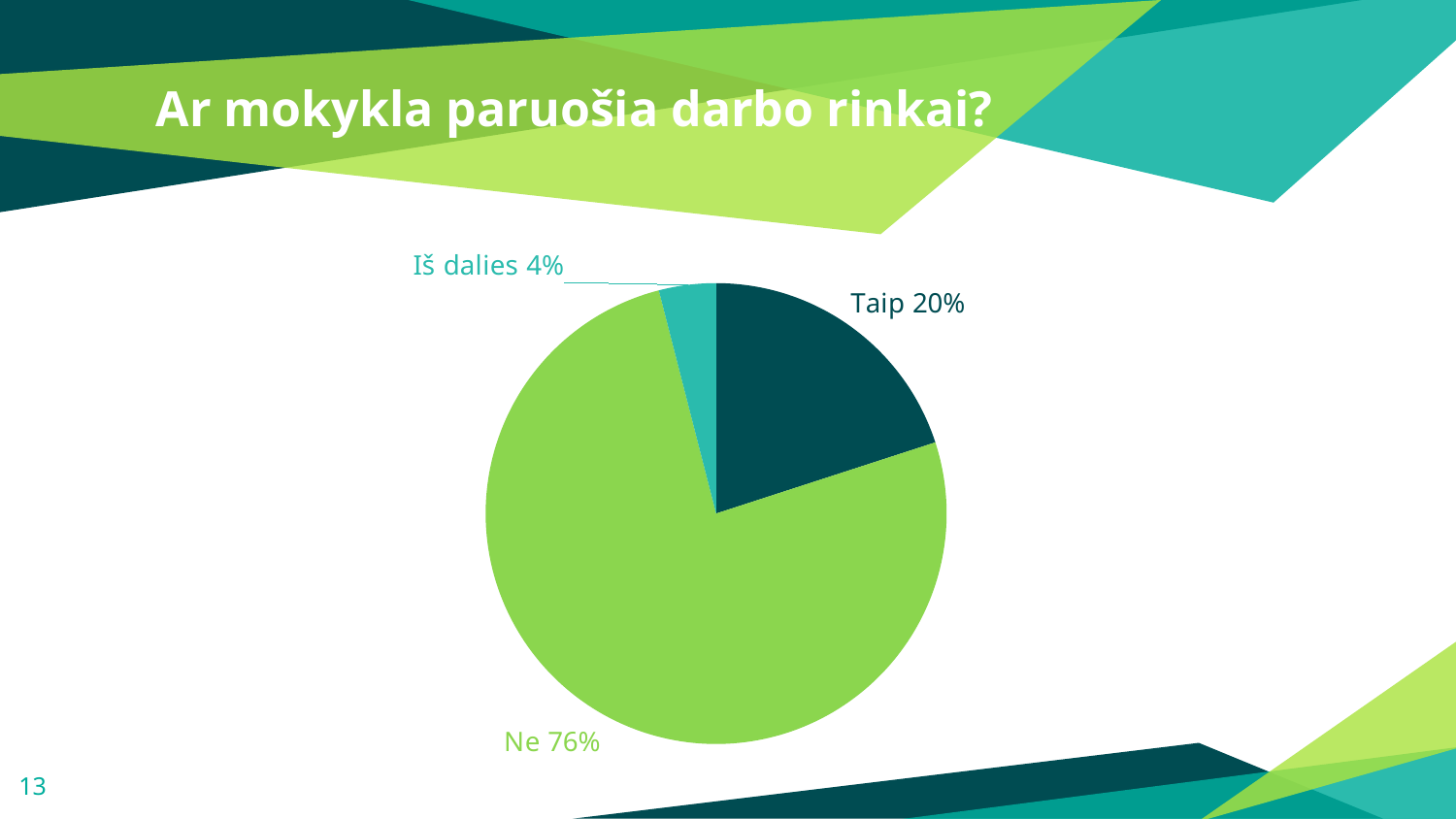
How many slices does the pie chart have? 3 What is the difference between the values for "Ne" and "Taip"? 56% What is the title of the slide containing the chart? Ar mokykla paruošia darbo rinkai? What is the difference between the values for "Taip" and "Iš dalies"? 16% What is the value for "Ne"? 76% Which category has the smallest share of the pie? Iš dalies What is the value for "Iš dalies"? 4% What colour is the "Ne" slice of the pie? light green What is the value for "Taip"? 20% What kind of chart is shown on the slide? pie chart Which category has the largest share of the pie? Ne Which is larger, the value for "Taip" or the value for "Iš dalies"? Taip